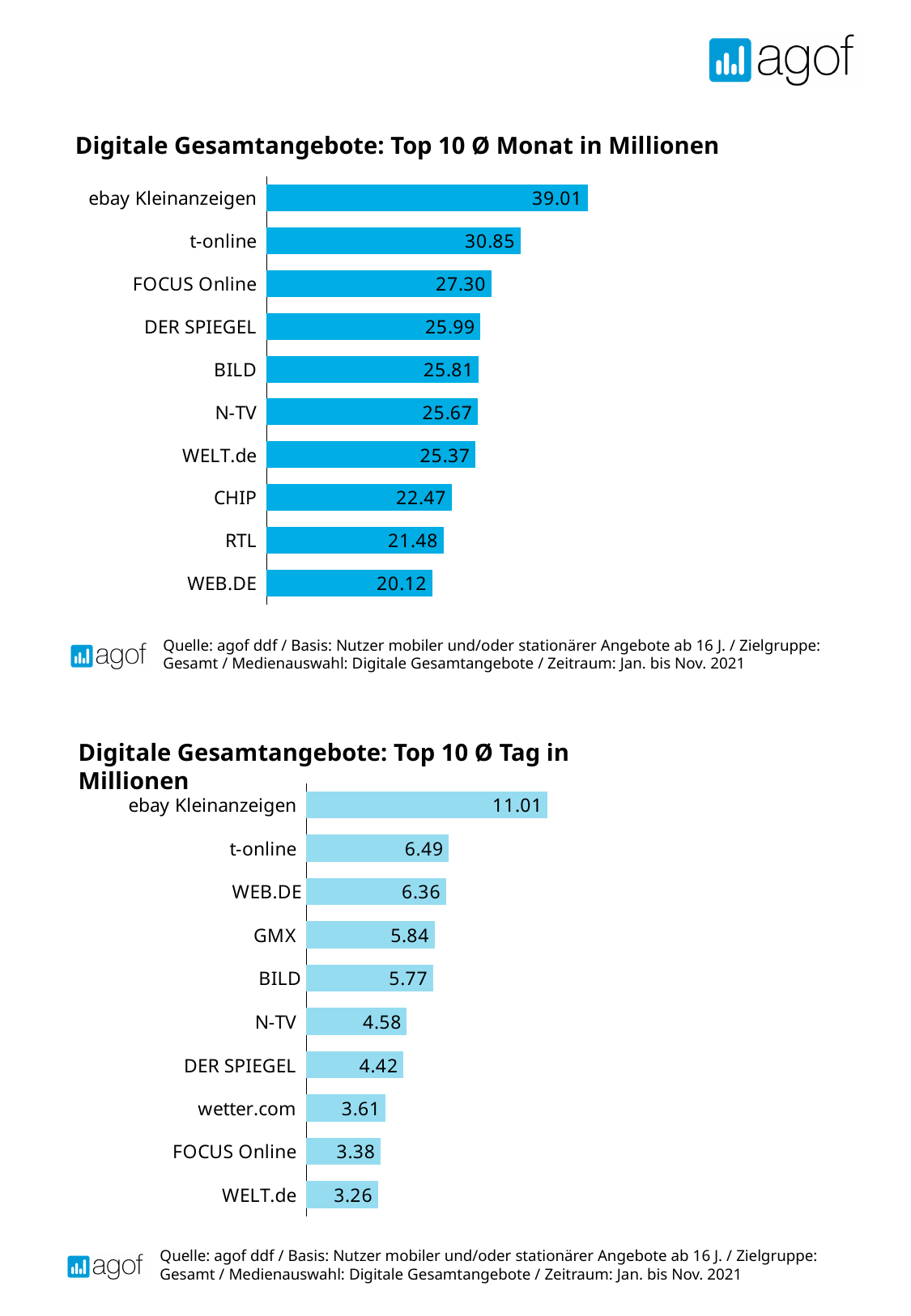
In the 'Digitale Gesamtangebote: Top 10 Ø Tag in Millionen' chart, what is the value for FOCUS Online? 3.38 In the 'Digitale Gesamtangebote: Top 10 Ø Tag in Millionen' chart, what is the value for GMX? 5.84 In the 'Digitale Gesamtangebote: Top 10 Ø Monat in Millionen' chart, how many categories are shown? 10 In the 'Digitale Gesamtangebote: Top 10 Ø Tag in Millionen' chart, which category has the lowest value? WELT.de In the 'Digitale Gesamtangebote: Top 10 Ø Monat in Millionen' chart, which category has the highest value? ebay Kleinanzeigen In the 'Digitale Gesamtangebote: Top 10 Ø Monat in Millionen' chart, what is the value for CHIP? 22.47 In the 'Digitale Gesamtangebote: Top 10 Ø Monat in Millionen' chart, what is the difference between ebay Kleinanzeigen and t-online? 8.16 In the 'Digitale Gesamtangebote: Top 10 Ø Tag in Millionen' chart, what is the difference between ebay Kleinanzeigen and WELT.de? 7.75 In the 'Digitale Gesamtangebote: Top 10 Ø Monat in Millionen' chart, which category has the lowest value? WEB.DE In the 'Digitale Gesamtangebote: Top 10 Ø Monat in Millionen' chart, what is the value for t-online? 30.85 In the 'Digitale Gesamtangebote: Top 10 Ø Tag in Millionen' chart, which is larger, the value for N-TV or the value for wetter.com? N-TV What kind of chart is the 'Digitale Gesamtangebote: Top 10 Ø Tag in Millionen' chart? Bar chart